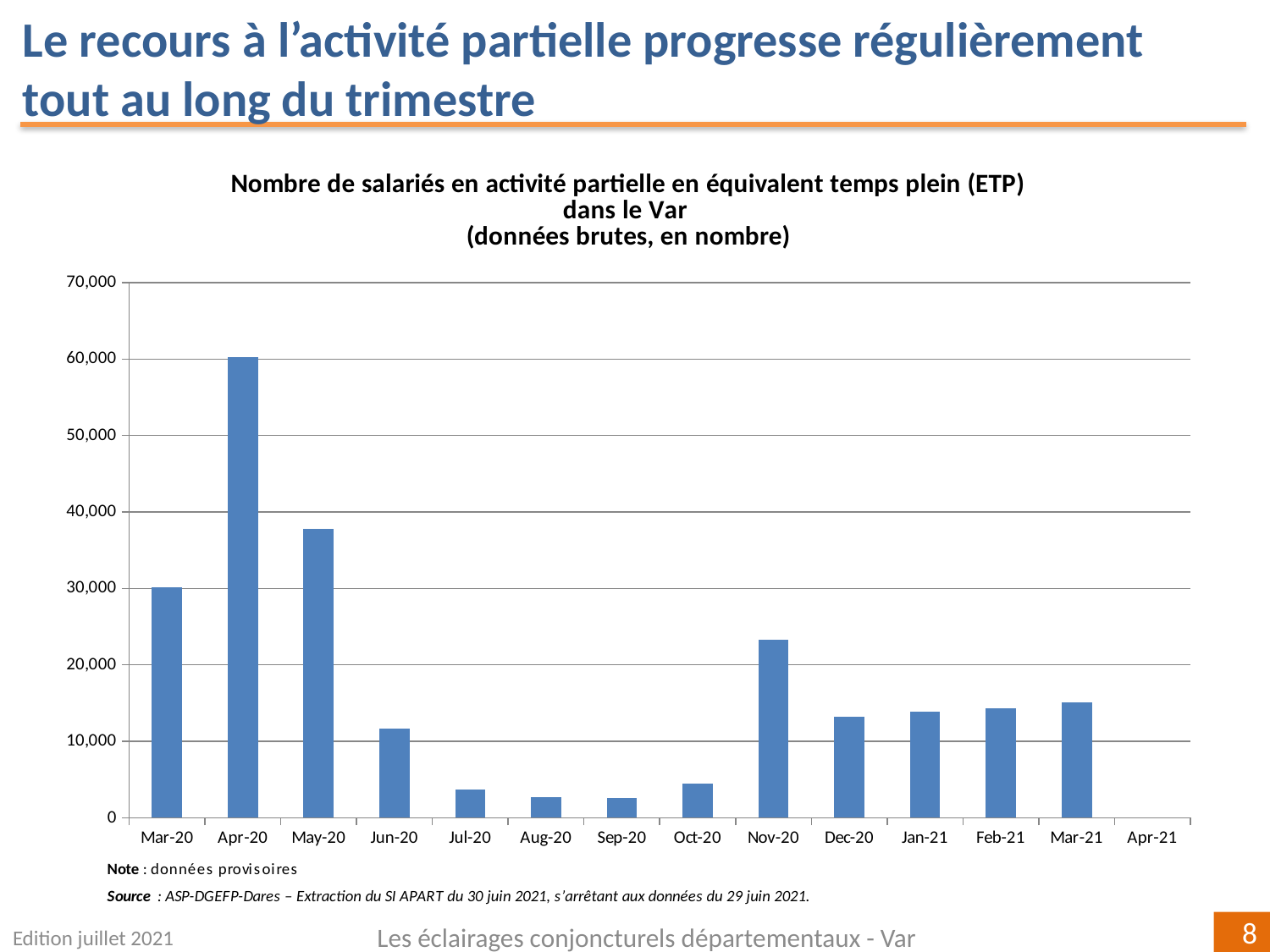
Which is larger, the value for Nov-20 or the value for Dec-20? Nov-20 What is the title of the chart? Nombre de salariés en activité partielle en équivalent temps plein (ETP) dans le Var (données brutes, en nombre) Which is larger, the value for May-20 or the value for Mar-20? May-20 Is the value for Nov-20 greater or less than 20,000? greater Is the value for Apr-20 greater or less than 50,000? greater Is the value for Mar-21 greater or less than 20,000? less How many month labels are shown on the x axis? 14 Which month has the highest number of salariés en activité partielle (ETP)? Apr-20 Do the values rise or fall from Dec-20 to Mar-21? rise What kind of chart is shown on the slide? bar chart